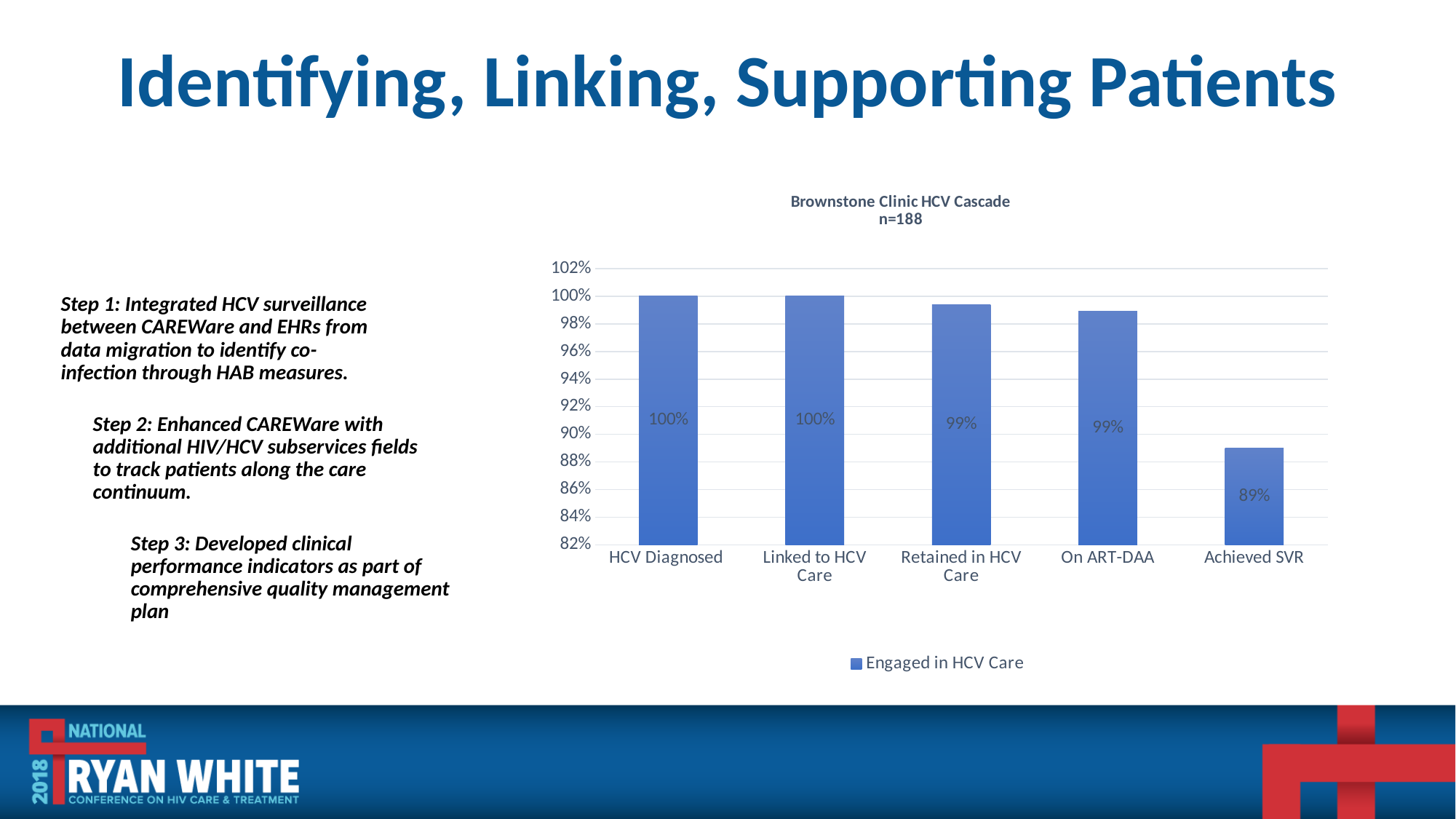
Which category has the lowest value? Achieved SVR How many series does the legend list? 1 Which is larger, the value for On ART-DAA or the value for Achieved SVR? On ART-DAA What is the value for Retained in HCV Care? 99% Is the value for Achieved SVR greater or less than 94%? less What is the value for HCV Diagnosed? 100% Do the values rise or fall from HCV Diagnosed to Achieved SVR? fall What is the value for Achieved SVR? 89% What is the difference between the values for Linked to HCV Care and Achieved SVR? 11% How many categories are shown on the x axis? 5 What kind of chart is shown? bar chart What is the value for On ART-DAA? 99%